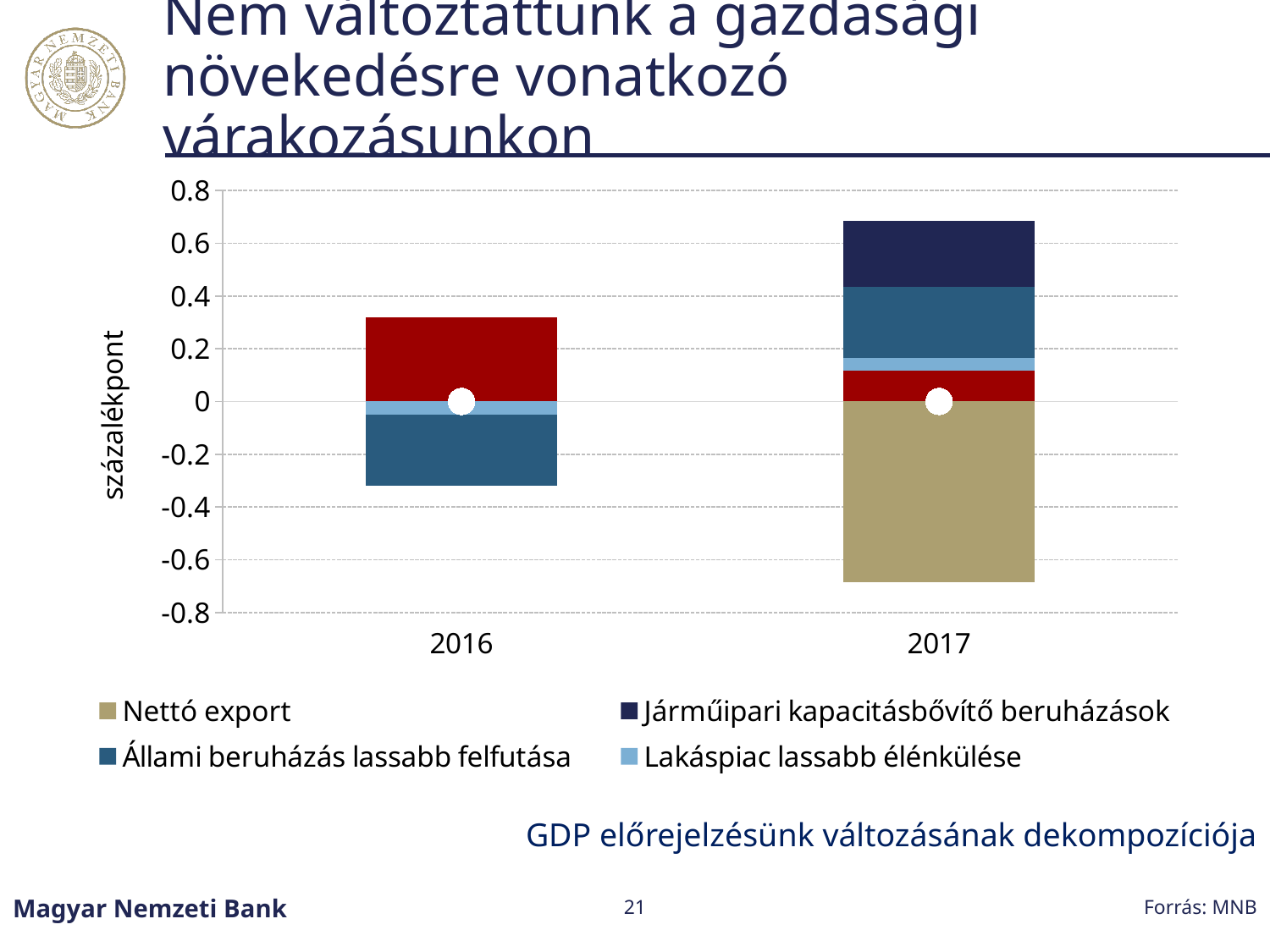
Is the top of the stacked bar for 2017 greater or less than 0.6? greater Is the bottom of the stacked bar for 2017 (the Nettó export segment) greater or less than -0.6? less Is the top of the stacked bar for 2016 greater or less than 0.2? greater Which year has the larger negative (below zero) portion of its stacked bar, 2016 or 2017? 2017 In which year does the Nettó export segment appear in the chart? 2017 How many categories (years) are shown on the x axis of the chart? 2 In which year does the Járműipari kapacitásbővítő beruházások segment appear in the chart? 2017 What kind of chart is shown on the slide? stacked bar chart What is the label of the vertical axis of the chart? százalékpont What is the caption printed below the chart's legend? GDP előrejelzésünk változásának dekompozíciója How many series does the chart's legend list? 4